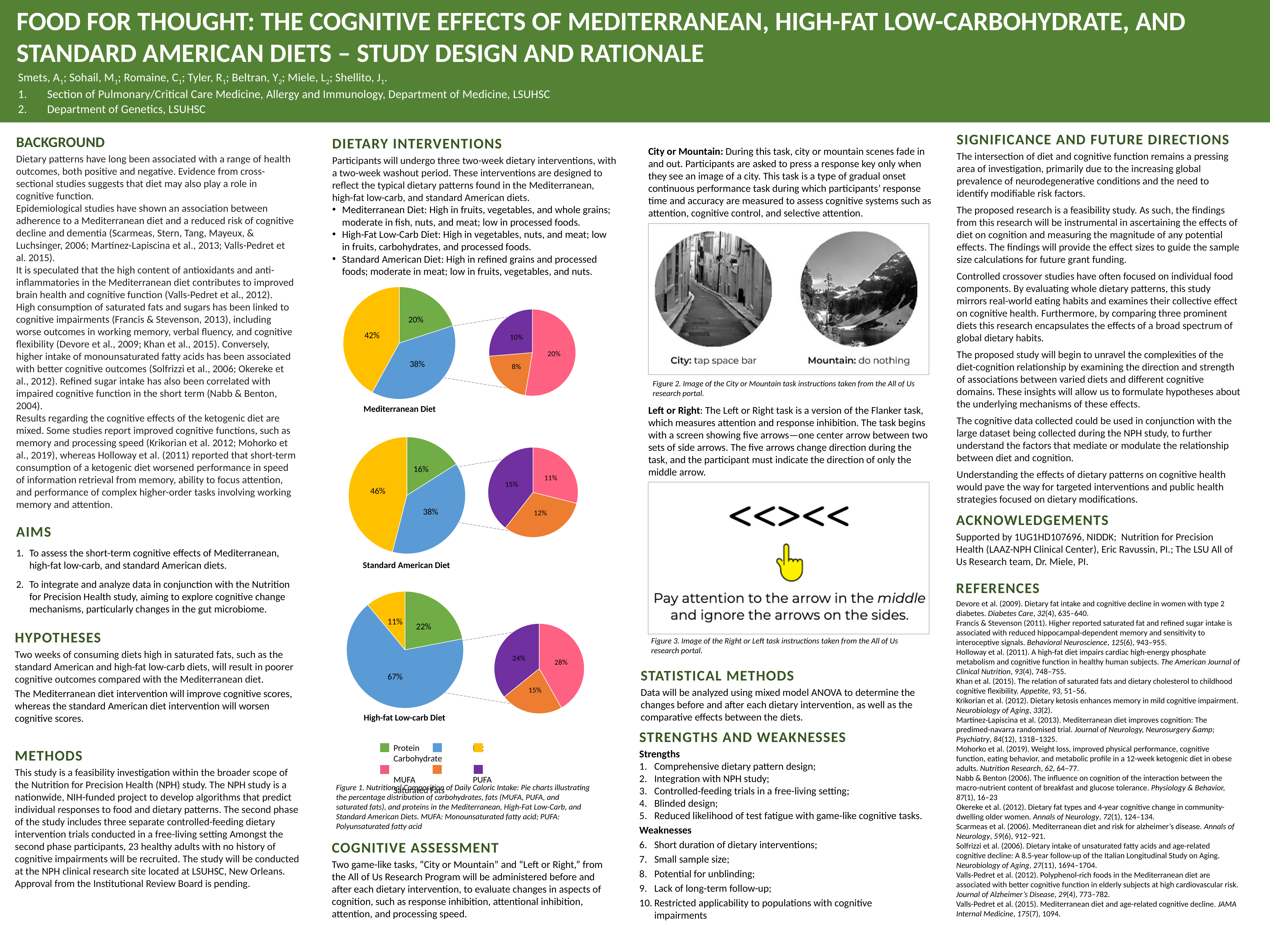
In the Standard American Diet chart, what percentage is shown for the purple slice of the secondary pie? 15% In the Mediterranean Diet pie chart, what is the value of the largest slice of the main pie? 42% In the Mediterranean Diet chart, what is the smallest value shown in the secondary (breakdown) pie? 8% Which diet has the larger yellow slice: the Standard American Diet (46%) or the Mediterranean Diet (42%)? Standard American Diet In the High-fat Low-carb Diet pie chart, what percentage is shown for the blue slice? 67% What kind of chart is used in Figure 1 to show the nutritional composition of each diet? pie chart In the Mediterranean Diet pie chart, what percentage is shown for the green slice? 20% How many diet pie charts are shown in Figure 1? 3 In the High-fat Low-carb Diet chart, what is the total of the three slices in the secondary pie (28%, 15%, 24%)? 67% In the Standard American Diet pie chart, what percentage is shown for the blue slice? 38% In the High-fat Low-carb Diet pie chart, what is the difference between the blue slice (67%) and the yellow slice (11%)? 56% In the High-fat Low-carb Diet pie chart, what percentage is shown for the yellow slice? 11%